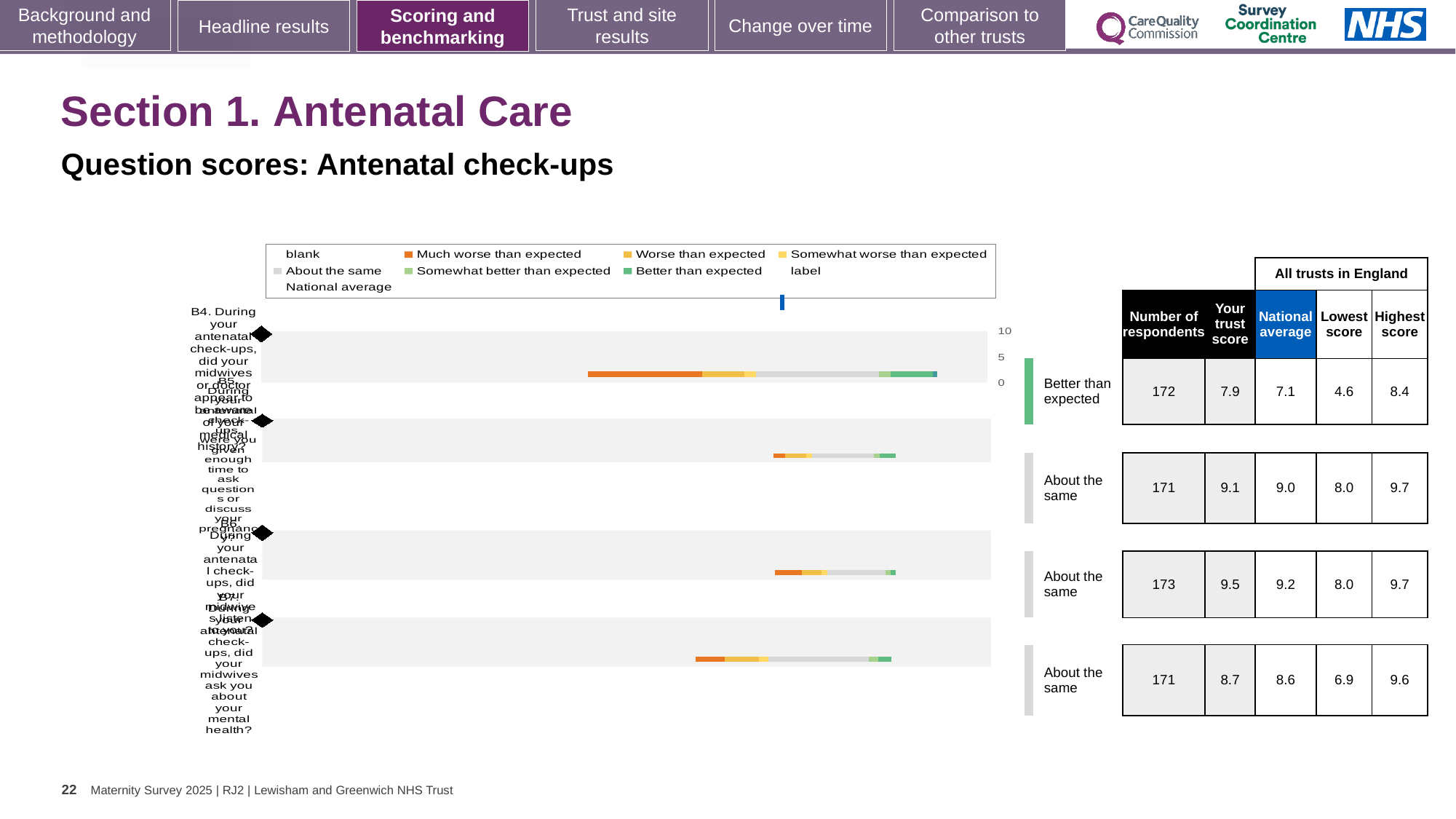
What is the trust score for the row rated 'Better than expected'? 7.9 Which row has the highest 'Your trust score' in the table? the third row from the top (9.5) Which row has the lowest 'Your trust score' in the table? the top row (7.9) What kind of chart is shown on the slide? bar chart What is the national average for the second row from the top? 9.0 How many question bars are plotted in the chart? 4 What is the highest score in England for the bottom row? 9.6 What colour represents 'Much worse than expected' in the legend? orange How many rows are labelled 'About the same'? 3 For the bottom row, which is larger: the trust score or the national average? the trust score (8.7) In the table beside the chart, what is the number of respondents for the top row (B4)? 172 For the top row, what is the difference between the trust score (7.9) and the national average (7.1)? 0.8